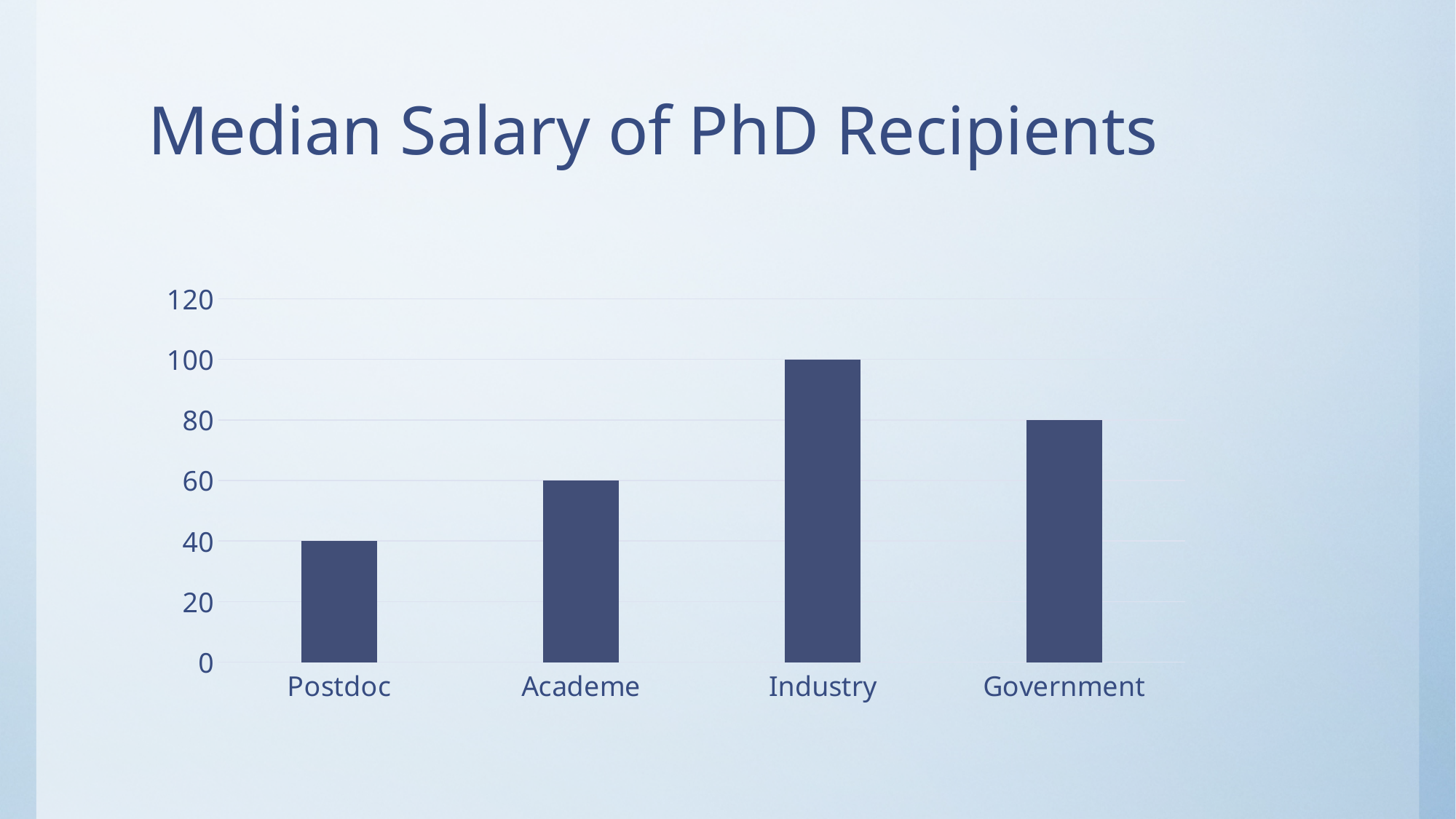
What kind of chart is shown on the slide? bar chart What is the value for Postdoc? 40 What is the value for Government? 80 Which category has the lowest value? Postdoc Which category has the highest value? Industry What is the difference between the values for Industry and Postdoc? 60 Which is larger, the value for Government or the value for Academe? Government What is the value for Academe? 60 Is the value for Academe greater or less than 80? less How many categories are shown on the x axis? 4 What is the title of the chart? Median Salary of PhD Recipients What is the value for Industry? 100